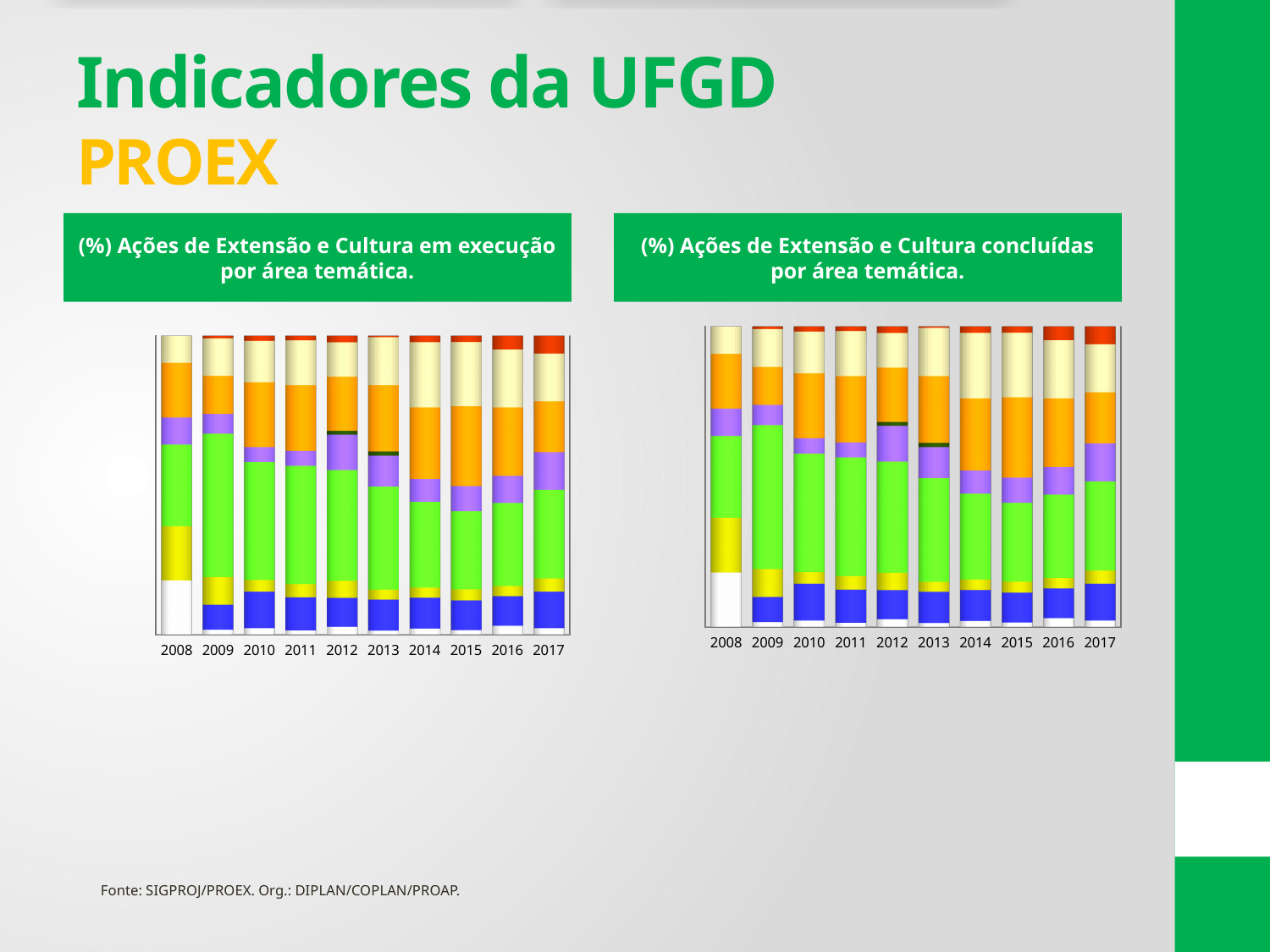
In the right chart (ações concluídas), which year has the largest white segment at the bottom of its bar? 2008 In the right chart (ações concluídas), how many bars are plotted? 10 In the right chart (ações concluídas), what is the last year shown on the x axis? 2017 What kind of chart is shown under the title "(%) Ações de Extensão e Cultura concluídas por área temática."? Stacked bar chart In the left chart (ações em execução), what is the first year shown on the x axis? 2008 In the left chart (ações em execução), how many years are shown on the x axis? 10 In the right chart (ações concluídas), is the red segment at the top of the bar larger in 2017 or in 2009? 2017 In the left chart (ações em execução), is the yellow segment larger in 2008 or in 2017? 2008 What kind of chart is shown under the title "(%) Ações de Extensão e Cultura em execução por área temática."? Stacked bar chart In the left chart (ações em execução), which year has the largest white segment at the bottom of its bar? 2008